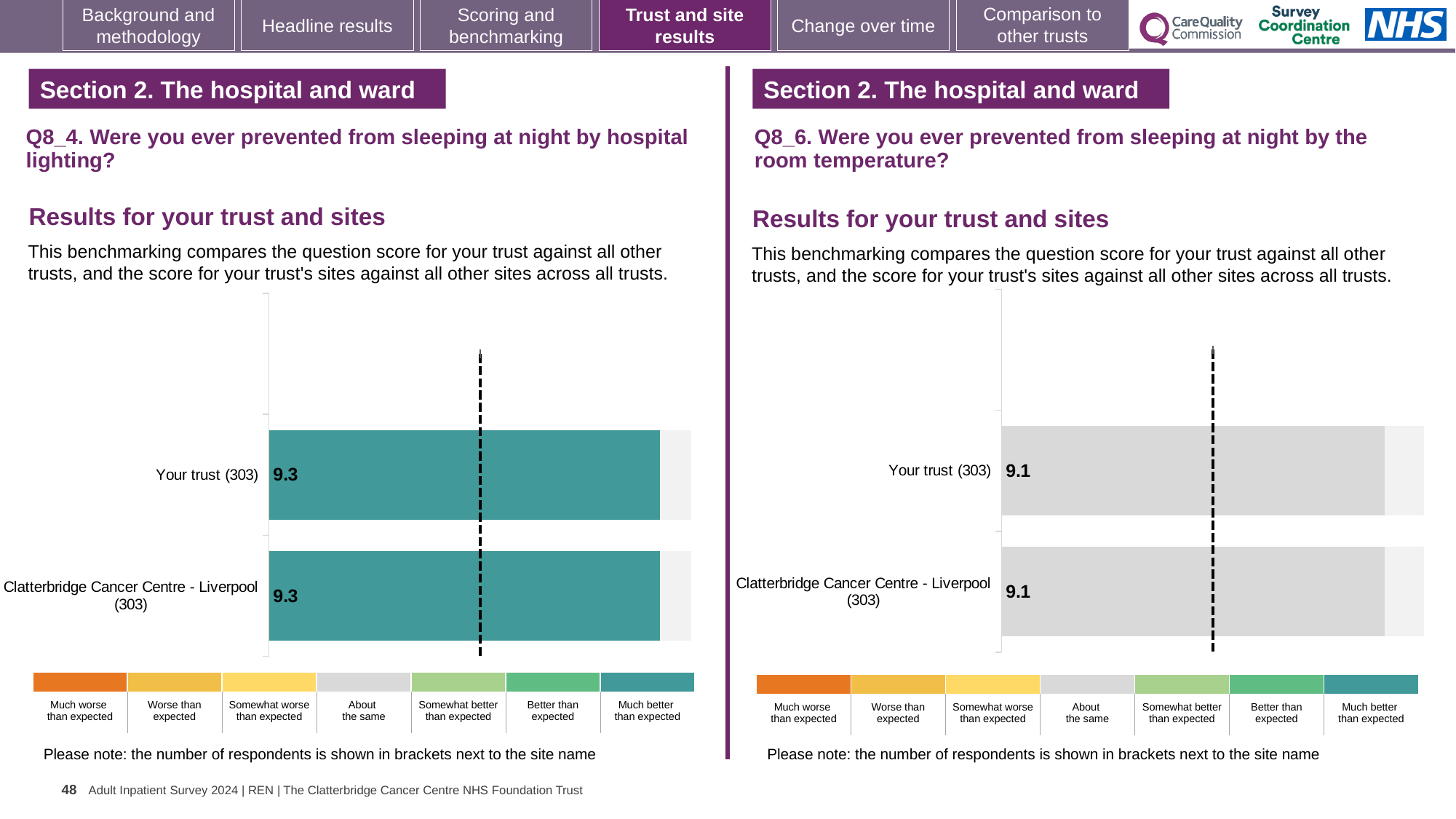
According to the colour key, which benchmark category do the bars in the Q8_4 hospital lighting chart fall into? Much better than expected How many bars are plotted in the Q8_4 hospital lighting chart? 2 In the Q8_6 room temperature chart, what is the difference between the score for Your trust and the score for Clatterbridge Cancer Centre - Liverpool? 0 In the Q8_4 hospital lighting chart, what is the difference between the score for Your trust and the score for Clatterbridge Cancer Centre - Liverpool? 0 How many bars are plotted in the Q8_6 room temperature chart? 2 Is the Your trust score in the Q8_4 hospital lighting chart higher or lower than the Your trust score in the Q8_6 room temperature chart? Higher What kind of chart is used for the Q8_4 hospital lighting results? Bar chart In the Q8_4 hospital lighting chart, what is the score for Clatterbridge Cancer Centre - Liverpool (303)? 9.3 In the Q8_4 hospital lighting chart, what is the score for Your trust (303)? 9.3 In the Q8_6 room temperature chart, what is the score for Clatterbridge Cancer Centre - Liverpool (303)? 9.1 In the Q8_6 room temperature chart, what is the score for Your trust (303)? 9.1 According to the colour key, which benchmark category do the bars in the Q8_6 room temperature chart fall into? About the same